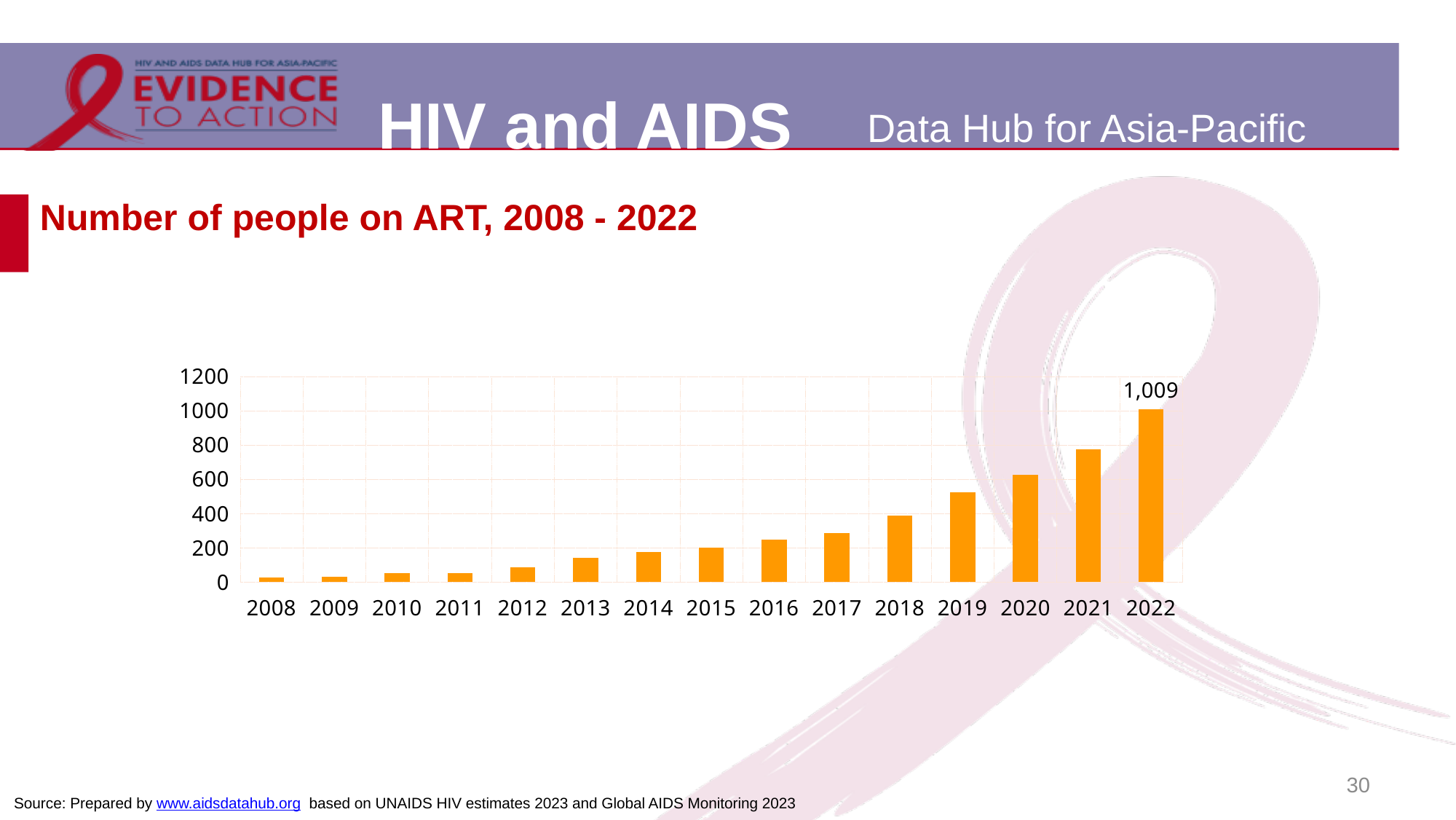
What is the title of the chart on the slide? Number of people on ART, 2008 - 2022 What is the number of people on ART in 2022? 1,009 Is the value for 2020 greater or less than 800? less Do the values rise or fall from 2008 to 2022? Rise Is the value for 2014 greater or less than 200? less Which year has the lowest number of people on ART? 2008 Is the value for 2021 greater or less than 600? greater Which year has the highest number of people on ART? 2022 What kind of chart is shown on the slide? Bar chart How many years are shown on the x axis of the chart? 15 Which year has a larger value, 2019 or 2016? 2019